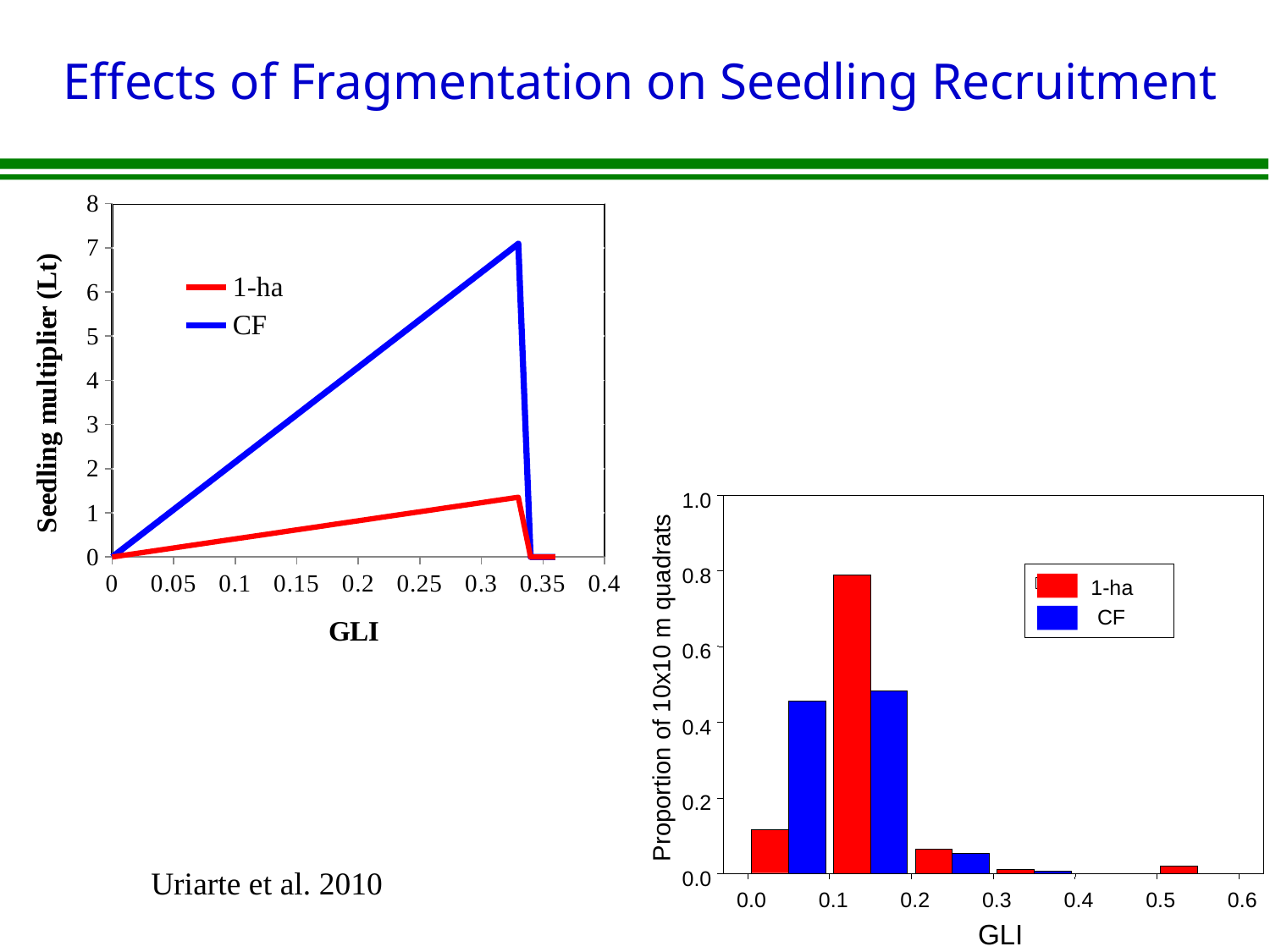
In the bottom-right bar chart, which series does the blue colour represent? CF In the top-left line chart, is the peak value of the CF line greater or less than 5? greater In the bottom-right bar chart, which series has the taller bar in the GLI bin around 0.05, 1-ha or CF? CF What kind of chart is the top-left chart with the y axis 'Seedling multiplier (Lt)'? line chart In the top-left line chart, how many series does the legend list? 2 In the top-left line chart, is the peak value of the 1-ha line greater or less than 2? less In the bottom-right bar chart, is the tallest 1-ha bar (at GLI about 0.1) greater or less than 0.6? greater In the top-left line chart, which series reaches the higher seedling multiplier, 1-ha or CF? CF In the top-left line chart, what is the label of the x axis? GLI In the top-left line chart, how does the CF line change as GLI increases from 0 to about 0.33? It rises What kind of chart is the bottom-right chart with the y axis 'Proportion of 10x10 m quadrats'? bar chart